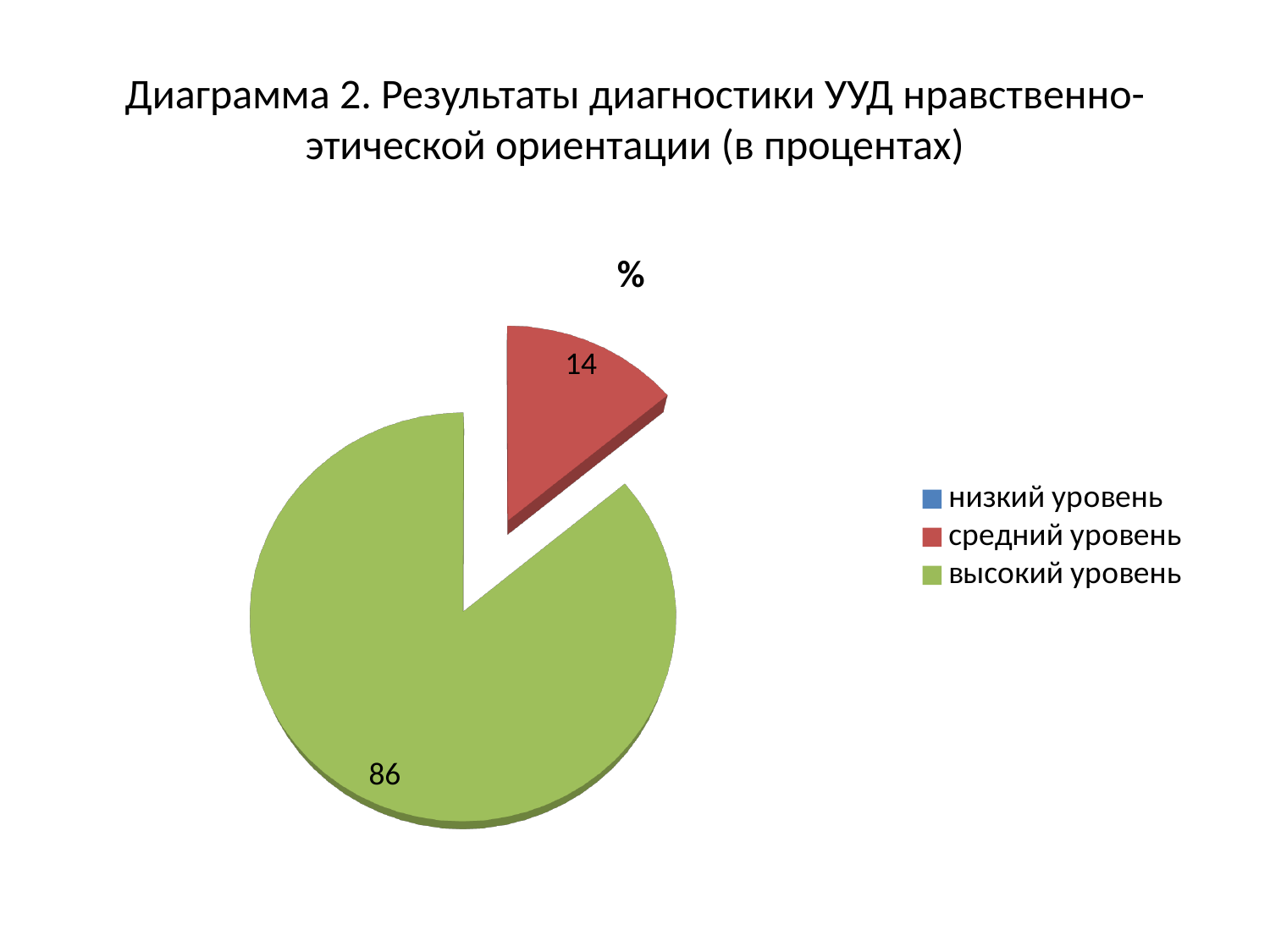
Which colour represents высокий уровень in the legend? green What is the title shown above the pie chart? % How many slices are visible in the pie? 2 What type of chart is shown on the slide? pie chart How many entries does the legend list? 3 Is the value for высокий уровень greater than the value for средний уровень? yes What is the difference between the values for высокий уровень and средний уровень? 72 Which category has the largest slice of the pie? высокий уровень What is the value for высокий уровень? 86 Which of the two visible slices is smaller, средний уровень or высокий уровень? средний уровень What is the value for средний уровень? 14